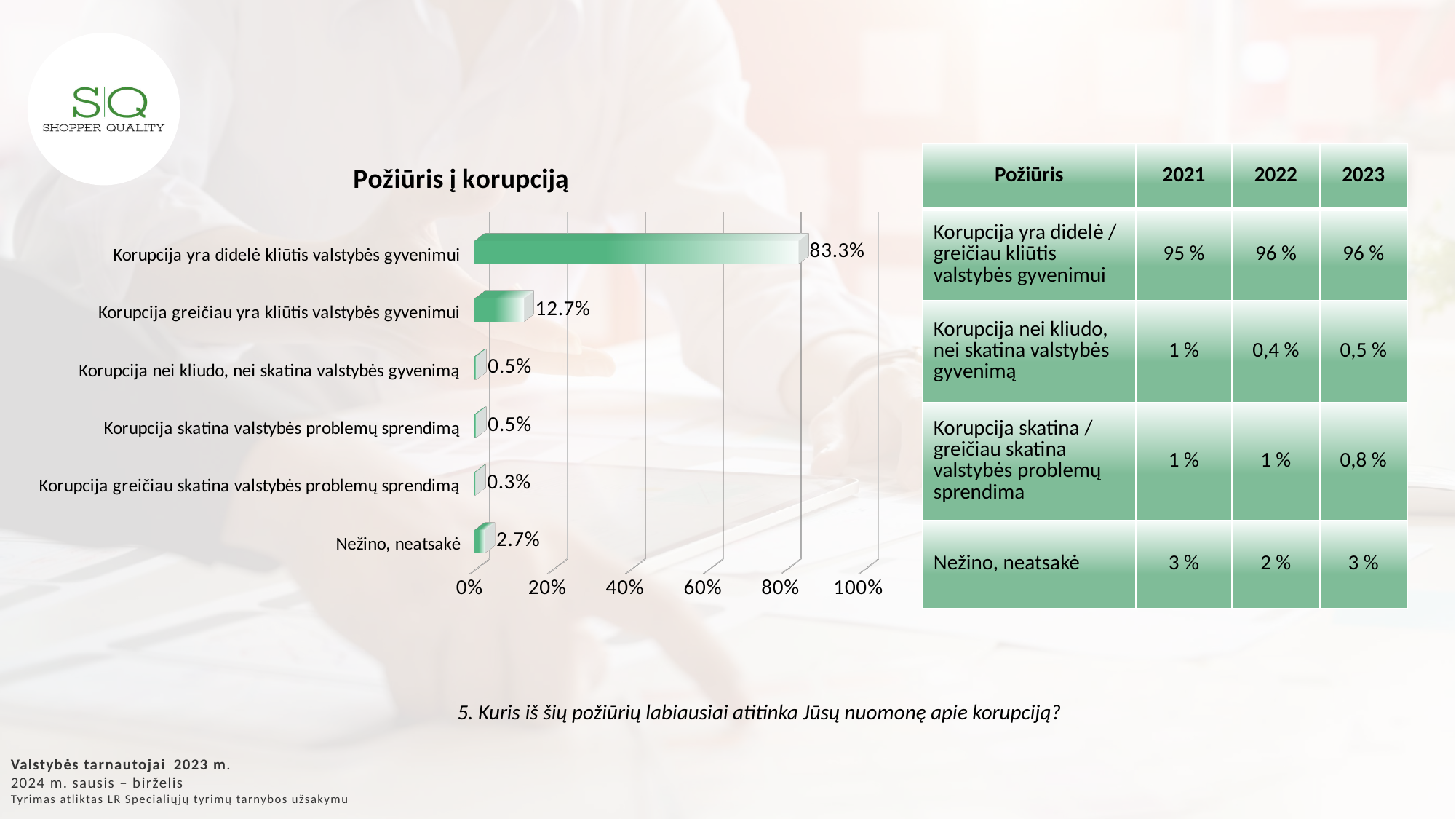
Which category has the lowest value in the chart? Korupcija greičiau skatina valstybės problemų sprendimą What is the value for "Korupcija greičiau skatina valstybės problemų sprendimą"? 0.3% What is the title of the chart? Požiūris į korupciją Which is larger: the value for "Nežino, neatsakė" or for "Korupcija nei kliudo, nei skatina valstybės gyvenimą"? Nežino, neatsakė Which category has the highest value in the chart? Korupcija yra didelė kliūtis valstybės gyvenimui How many categories are shown in the chart? 6 What is the value for "Korupcija yra didelė kliūtis valstybės gyvenimui" in the chart? 83.3% What is the value for "Nežino, neatsakė" in the chart? 2.7% What is the value for "Korupcija greičiau yra kliūtis valstybės gyvenimui"? 12.7% What kind of chart is shown on the slide? bar chart What is the difference between the values for "Korupcija yra didelė kliūtis valstybės gyvenimui" and "Korupcija greičiau yra kliūtis valstybės gyvenimui"? 70.6% Is the value for "Korupcija yra didelė kliūtis valstybės gyvenimui" greater or less than 80%? greater